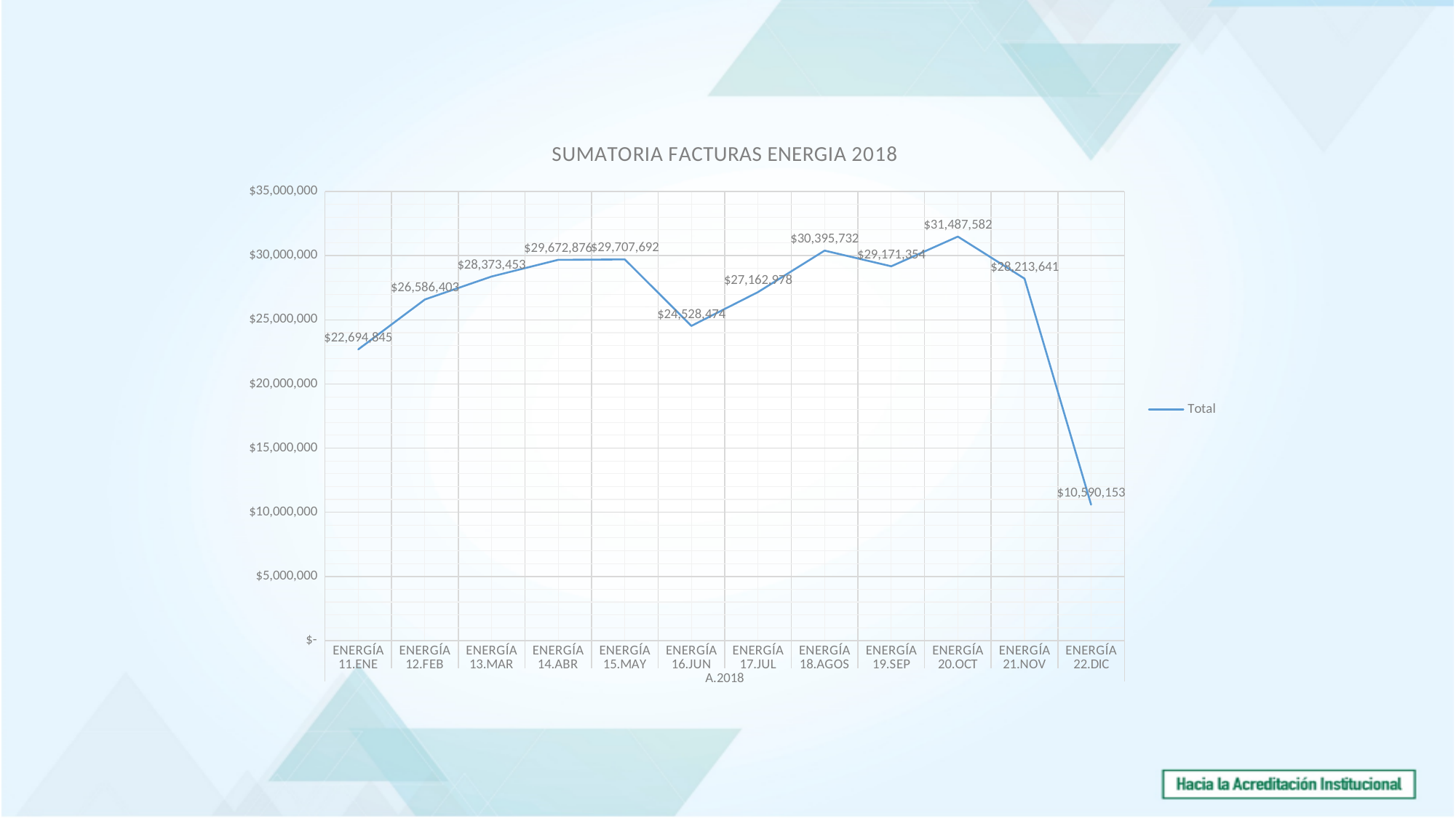
Which category has the lowest value? ENERGÍA 22.DIC How many series does the legend list? 1 How many data points are plotted on the line? 12 What is the difference between the values for ENERGÍA 20.OCT and ENERGÍA 22.DIC? $20,897,429 What is the value for ENERGÍA 11.ENE? $22,694,845 Which is larger, the value for ENERGÍA 18.AGOS or ENERGÍA 19.SEP? ENERGÍA 18.AGOS What type of chart is shown on the slide? Line chart Which category has the highest value? ENERGÍA 20.OCT What is the title of the chart? SUMATORIA FACTURAS ENERGIA 2018 Do the values rise or fall from ENERGÍA 20.OCT to ENERGÍA 22.DIC? fall Is the value for ENERGÍA 16.JUN greater or less than $25,000,000? less What is the value for ENERGÍA 18.AGOS? $30,395,732